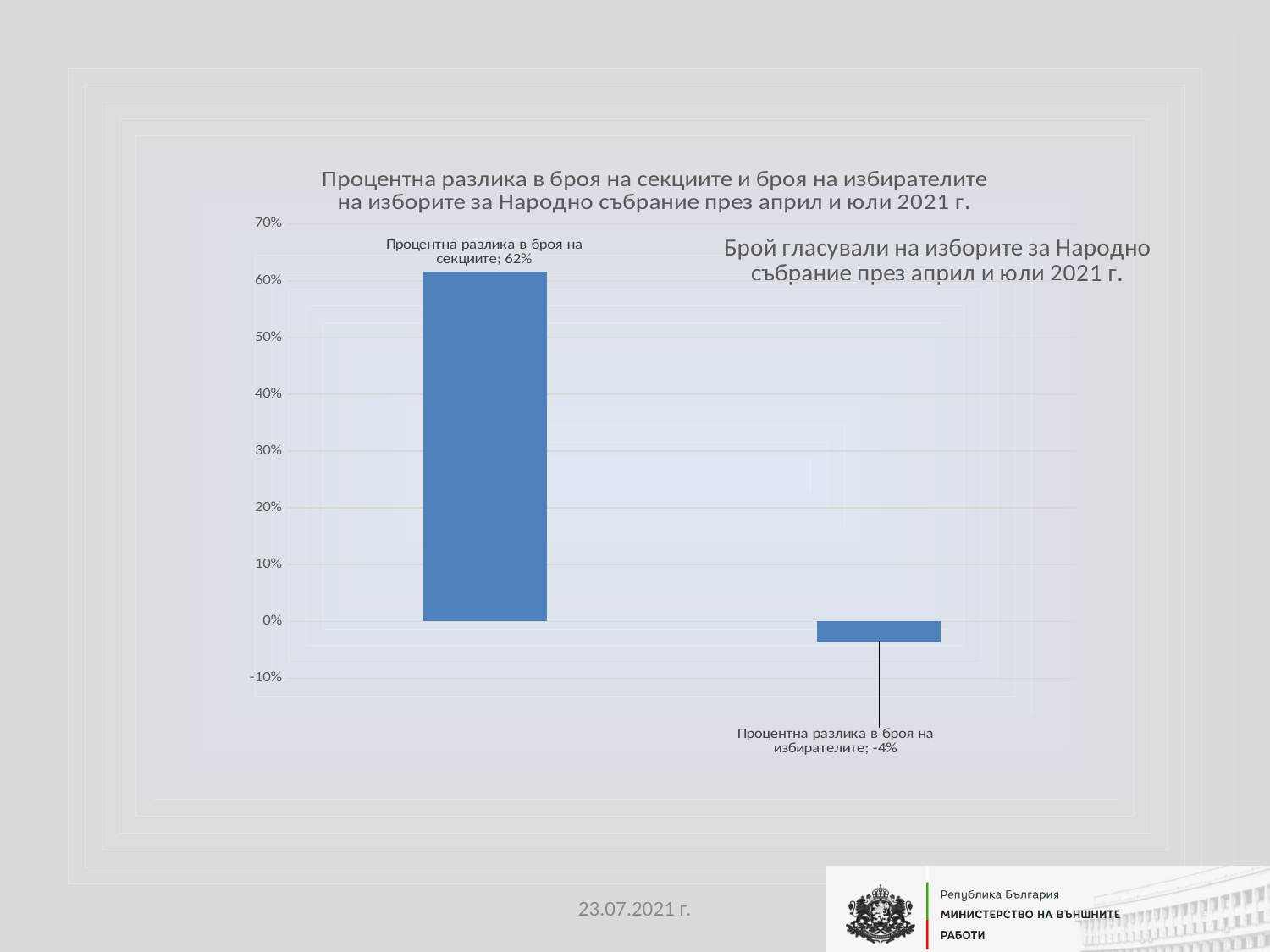
What kind of chart is shown on the slide? Bar chart What is the difference between the value for "Процентна разлика в броя на секциите" and the value for "Процентна разлика в броя на избирателите"? 66 percentage points What is the value for "Процентна разлика в броя на секциите"? 62% Which is larger: the value for "Процентна разлика в броя на секциите" or the value for "Процентна разлика в броя на избирателите"? Процентна разлика в броя на секциите What is the value for "Процентна разлика в броя на избирателите"? -4% Is the value for "Процентна разлика в броя на избирателите" greater or less than 0%? less Which category has the lowest value? Процентна разлика в броя на избирателите Which category has the highest value? Процентна разлика в броя на секциите Is the value for "Процентна разлика в броя на секциите" greater or less than 50%? greater Do the values rise or fall from the first bar to the second bar? Fall How many bars are plotted in the chart? 2 What is the title of the chart? Процентна разлика в броя на секциите и броя на избирателите на изборите за Народно събрание през април и юли 2021 г.